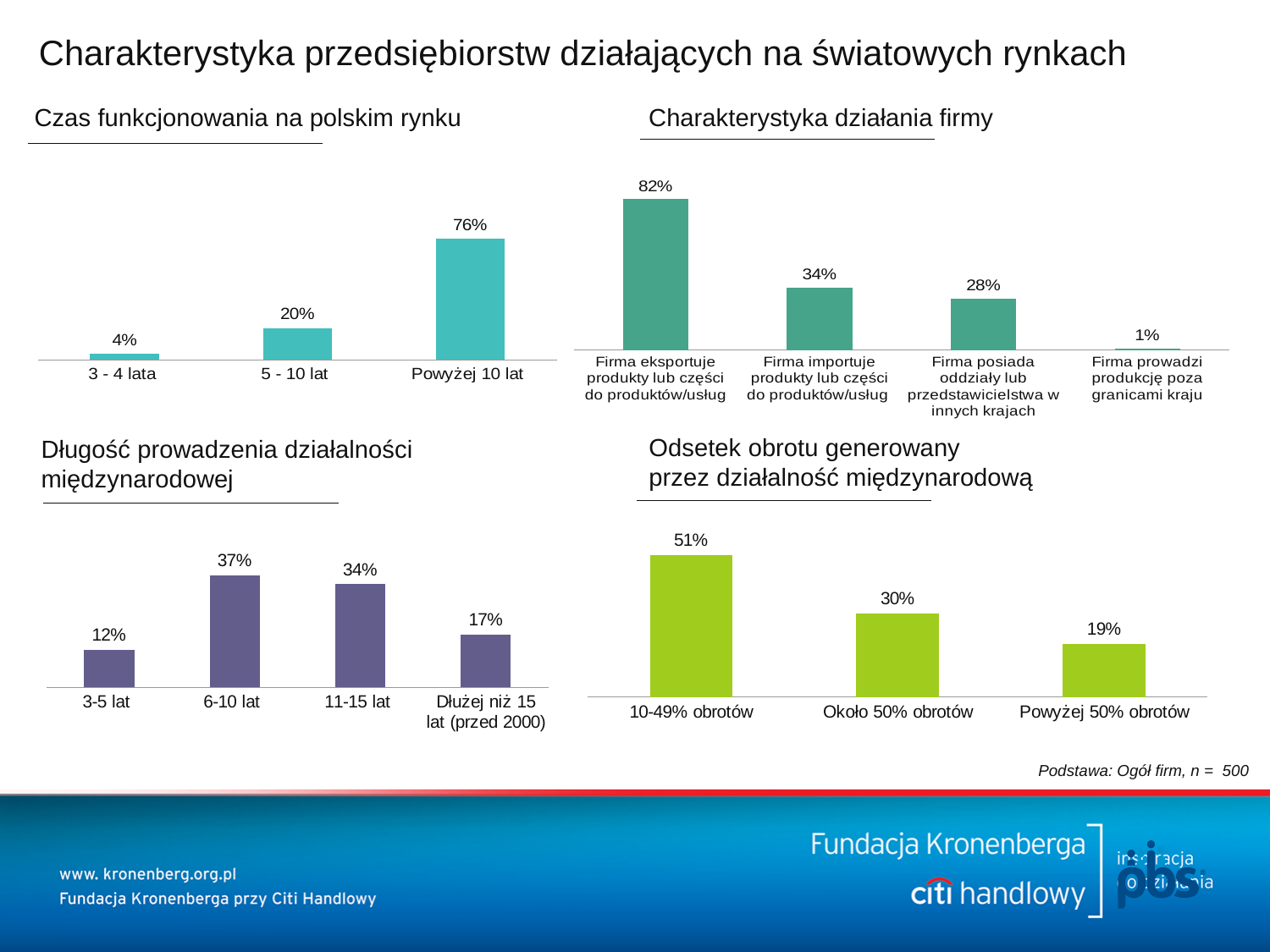
In the chart 'Długość prowadzenia działalności międzynarodowej', what is the value for '11-15 lat'? 34% In the chart 'Charakterystyka działania firmy', what is the difference between the values for 'Firma eksportuje produkty lub części do produktów/usług' and 'Firma posiada oddziały lub przedstawicielstwa w innych krajach'? 54% In the chart 'Charakterystyka działania firmy', which category has the highest value? Firma eksportuje produkty lub części do produktów/usług In the chart 'Odsetek obrotu generowany przez działalność międzynarodową', what is the value for 'Około 50% obrotów'? 30% In the chart 'Długość prowadzenia działalności międzynarodowej', which category has the highest value? 6-10 lat In the chart 'Czas funkcjonowania na polskim rynku', what is the value for 'Powyżej 10 lat'? 76% How many categories are shown in the chart 'Charakterystyka działania firmy'? 4 In the chart 'Odsetek obrotu generowany przez działalność międzynarodową', do the values rise or fall from left to right? fall In the chart 'Czas funkcjonowania na polskim rynku', which category has the lowest value? 3 - 4 lata In the chart 'Charakterystyka działania firmy', what is the value for 'Firma importuje produkty lub części do produktów/usług'? 34% What kind of chart is 'Czas funkcjonowania na polskim rynku'? bar chart In the chart 'Długość prowadzenia działalności międzynarodowej', which is larger: the value for '3-5 lat' or the value for 'Dłużej niż 15 lat (przed 2000)'? Dłużej niż 15 lat (przed 2000)